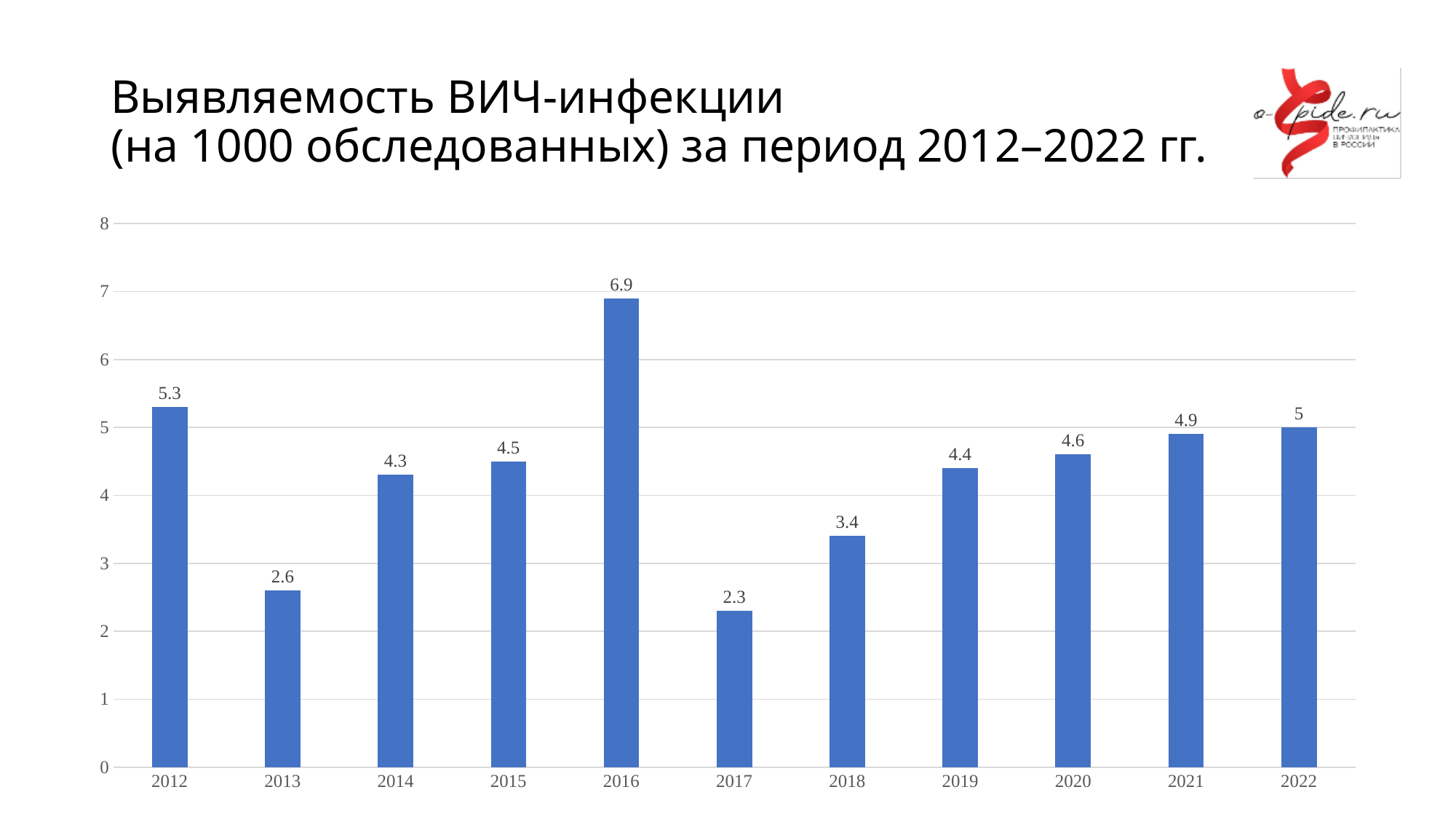
What is the value for 2013? 2.6 What is the value for 2022? 5 What is the value for 2016? 6.9 What is the difference between the values for 2021 and 2020? 0.3 What is the difference between the values for 2016 and 2017? 4.6 Which is larger, the value for 2012 or the value for 2022? 2012 Is the value for 2018 greater or less than 4? less What kind of chart is this? bar chart Which year has the highest value? 2016 Which year has the lowest value? 2017 How many years are shown on the x axis? 11 Do the values rise or fall from 2017 to 2021? rise